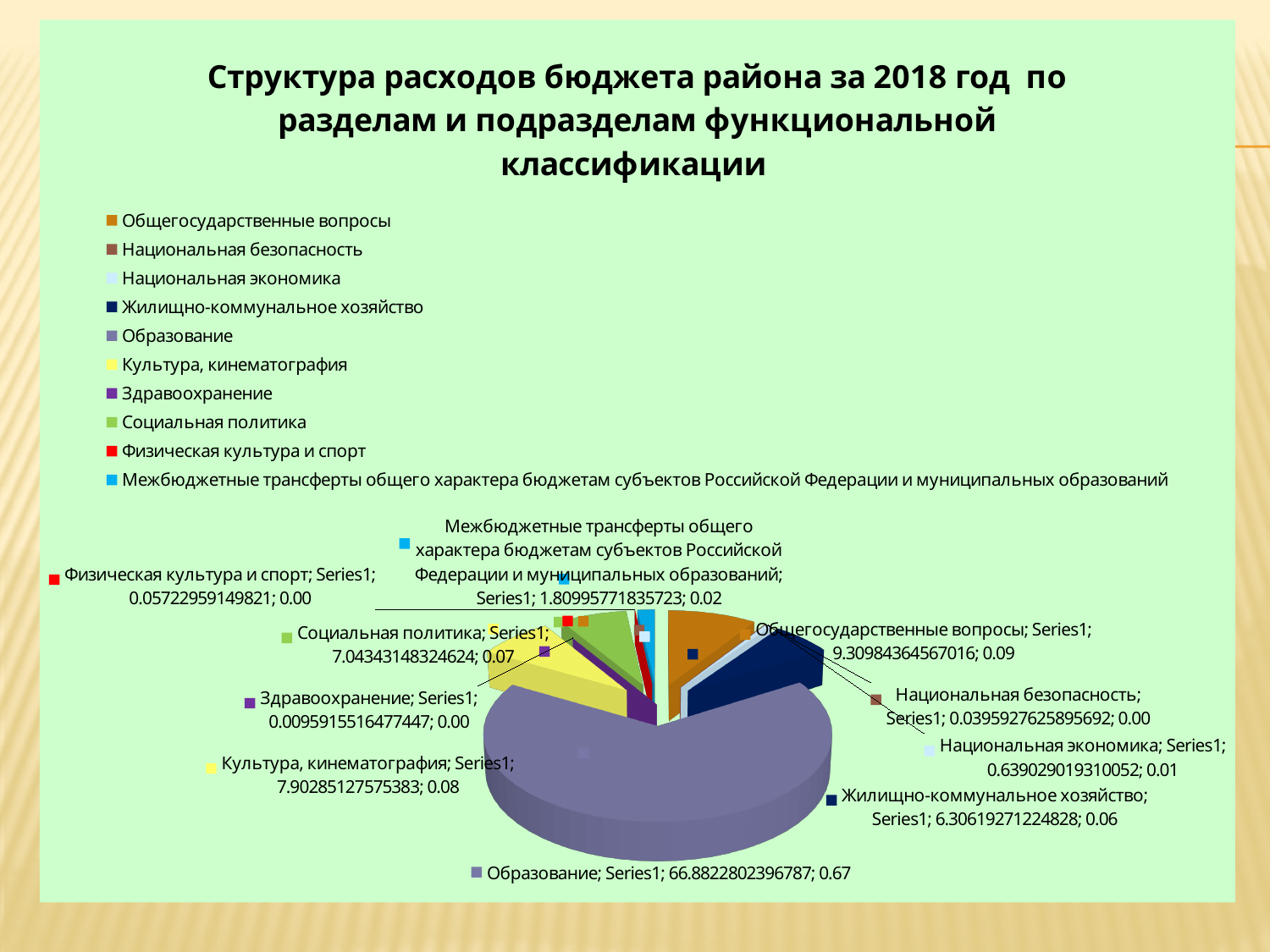
What is the value shown for Культура, кинематография? 7.90285127575383 What kind of chart is shown on the slide? pie chart How many categories (slices) does the pie chart have? 10 What is the value shown for Общегосударственные вопросы? 9.30984364567016 Which category has the smallest value in the pie chart? Здравоохранение What share of the pie does Общегосударственные вопросы represent, as printed on its data label? 0.09 What is the value shown for Жилищно-коммунальное хозяйство? 6.30619271224828 Which is larger: the value for Социальная политика or the value for Жилищно-коммунальное хозяйство? Социальная политика What is the title of the chart on the slide? Структура расходов бюджета района за 2018 год по разделам и подразделам функциональной классификации What share of the pie does Образование represent, as printed on its data label? 0.67 What is the value shown for Образование? 66.8822802396787 Which category has the largest slice of the pie? Образование